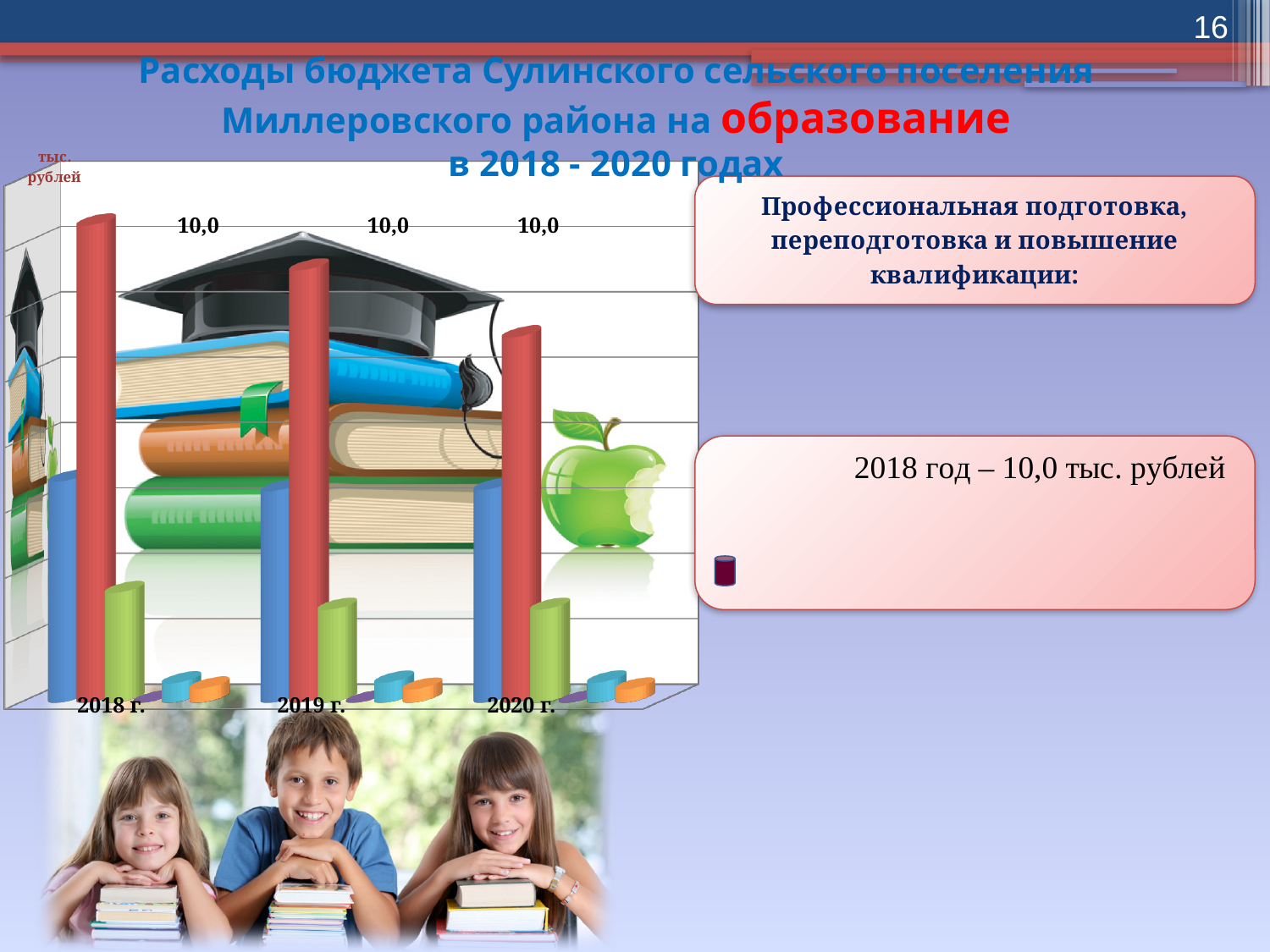
Which years does the chart title say the education expenditures cover? 2018 - 2020 How many year categories are shown on the x axis of the chart? 3 Which coloured bar is the tallest in the 2019 г. group? the red bar Do the values of the red bars rise, fall or stay the same from 2018 г. to 2020 г.? fall What kind of chart is shown on the slide? bar chart In 2018 г., which is larger: the red bar or the green bar? the red bar What unit is shown on the vertical axis label of the chart? тыс. рублей In 2020 г., which is larger: the blue bar or the orange bar? the blue bar